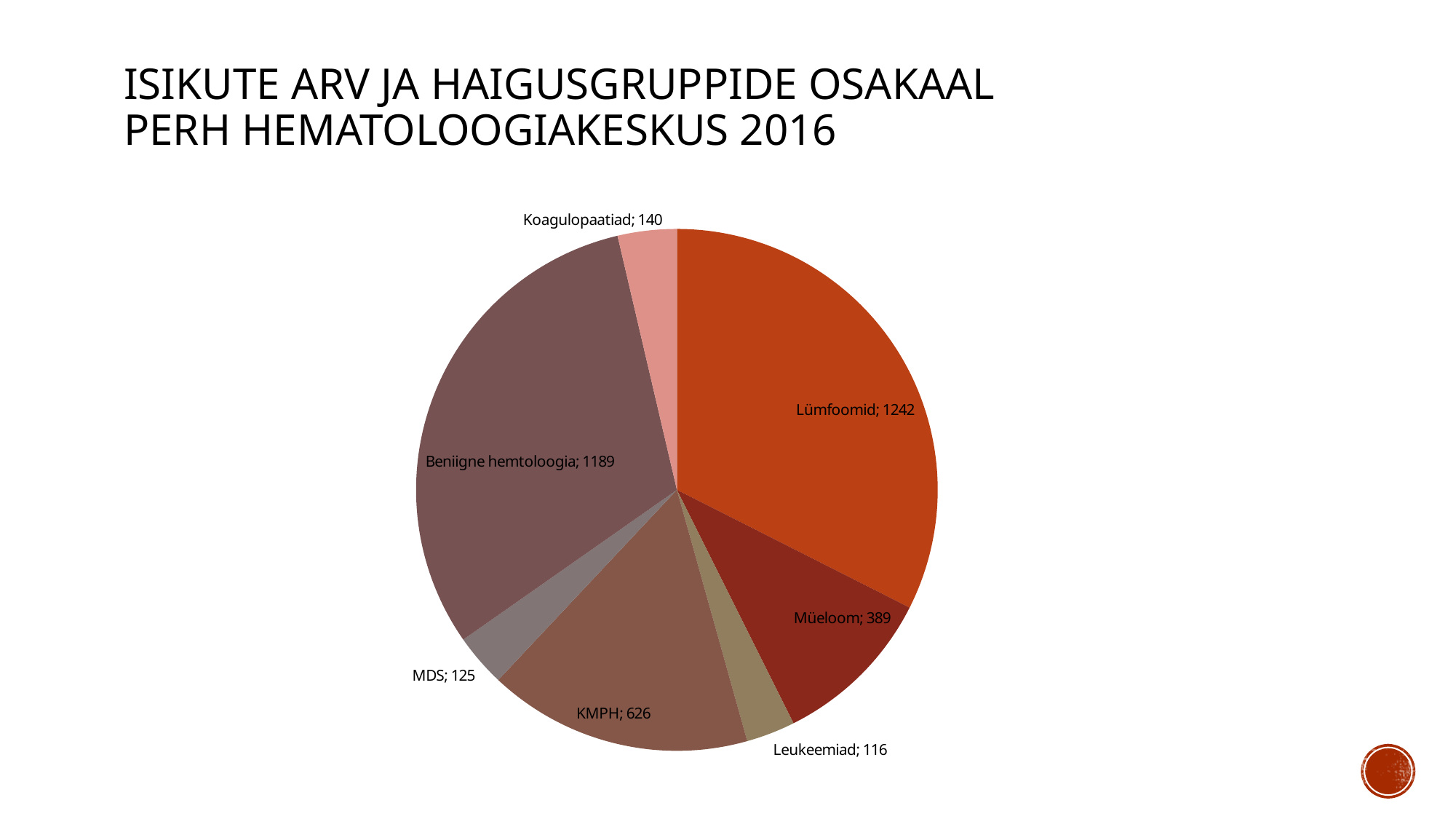
Which category has the largest value? Lümfoomid What is the value for Lümfoomid? 1242 What is the difference between Lümfoomid and Beniigne hemtoloogia? 53 What is the difference between KMPH and Müeloom? 237 Which is larger, MDS or Koagulopaatiad? Koagulopaatiad What is the value for Beniigne hemtoloogia? 1189 What is the total of all slices in the pie chart? 3827 How many slices does the pie chart have? 7 What is the value for KMPH? 626 What type of chart is shown on the slide? Pie chart What is the value for Koagulopaatiad? 140 Which category has the smallest value? Leukeemiad